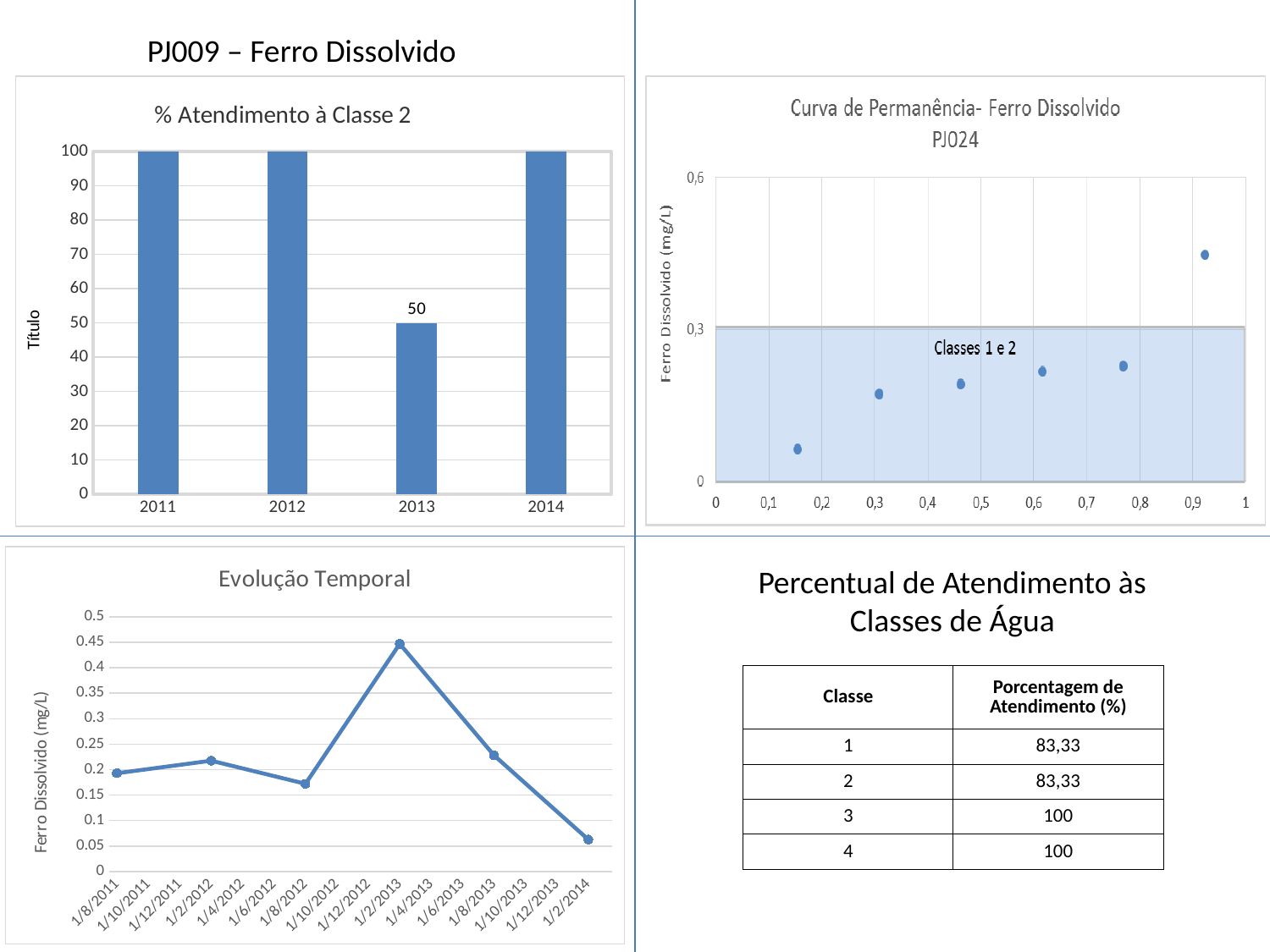
In the '% Atendimento à Classe 2' chart, what is the value for 2011? 100 In the 'Evolução Temporal' chart, is the value at 1/2/2013 greater or less than 0.4? greater In the 'Curva de Permanência- Ferro Dissolvido PJ024' chart, how many data points are plotted? 6 In the '% Atendimento à Classe 2' chart, which year has the lowest value? 2013 What kind of chart is the '% Atendimento à Classe 2' chart? bar chart In the '% Atendimento à Classe 2' chart, how many years are shown on the x axis? 4 In the '% Atendimento à Classe 2' chart, is the value for 2014 larger or smaller than the value for 2013? larger In the 'Evolução Temporal' chart, at which date does the line reach its highest value? 1/2/2013 In the 'Curva de Permanência- Ferro Dissolvido PJ024' chart, is the value of the rightmost point (near 0,9 on the x axis) greater or less than 0,3? greater In the 'Evolução Temporal' chart, at which date does the line reach its lowest value? 1/2/2014 In the '% Atendimento à Classe 2' chart, what is the value for 2013? 50 In the '% Atendimento à Classe 2' chart, what is the difference between the values for 2012 and 2013? 50